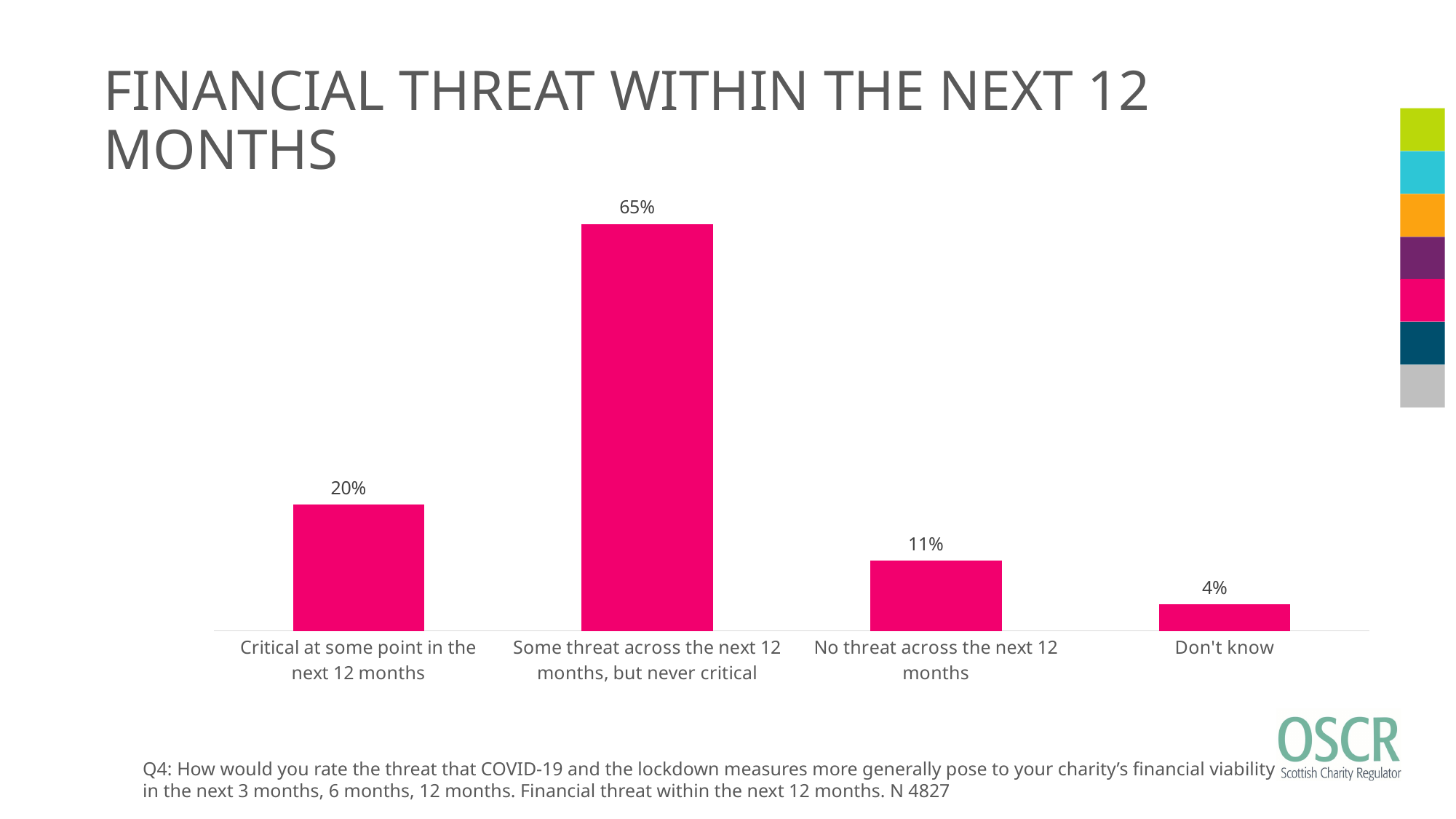
What kind of chart is shown on the slide? Bar chart What is the sample size (N) stated in the footnote below the chart? 4827 What is the value for 'Some threat across the next 12 months, but never critical'? 65% What percentage of respondents said there was no threat across the next 12 months? 11% Which is larger: the value for 'Critical at some point in the next 12 months' or the value for 'No threat across the next 12 months'? Critical at some point in the next 12 months What percentage of respondents said the financial threat would be critical at some point in the next 12 months? 20% How many categories are shown on the chart? 4 What is the difference between the 'Some threat across the next 12 months, but never critical' value and the 'Critical at some point in the next 12 months' value? 45% Which category has the lowest value? Don't know Which category has the highest value? Some threat across the next 12 months, but never critical What is the value for 'Don't know'? 4% What is the difference between the 'No threat across the next 12 months' value and the 'Don't know' value? 7%